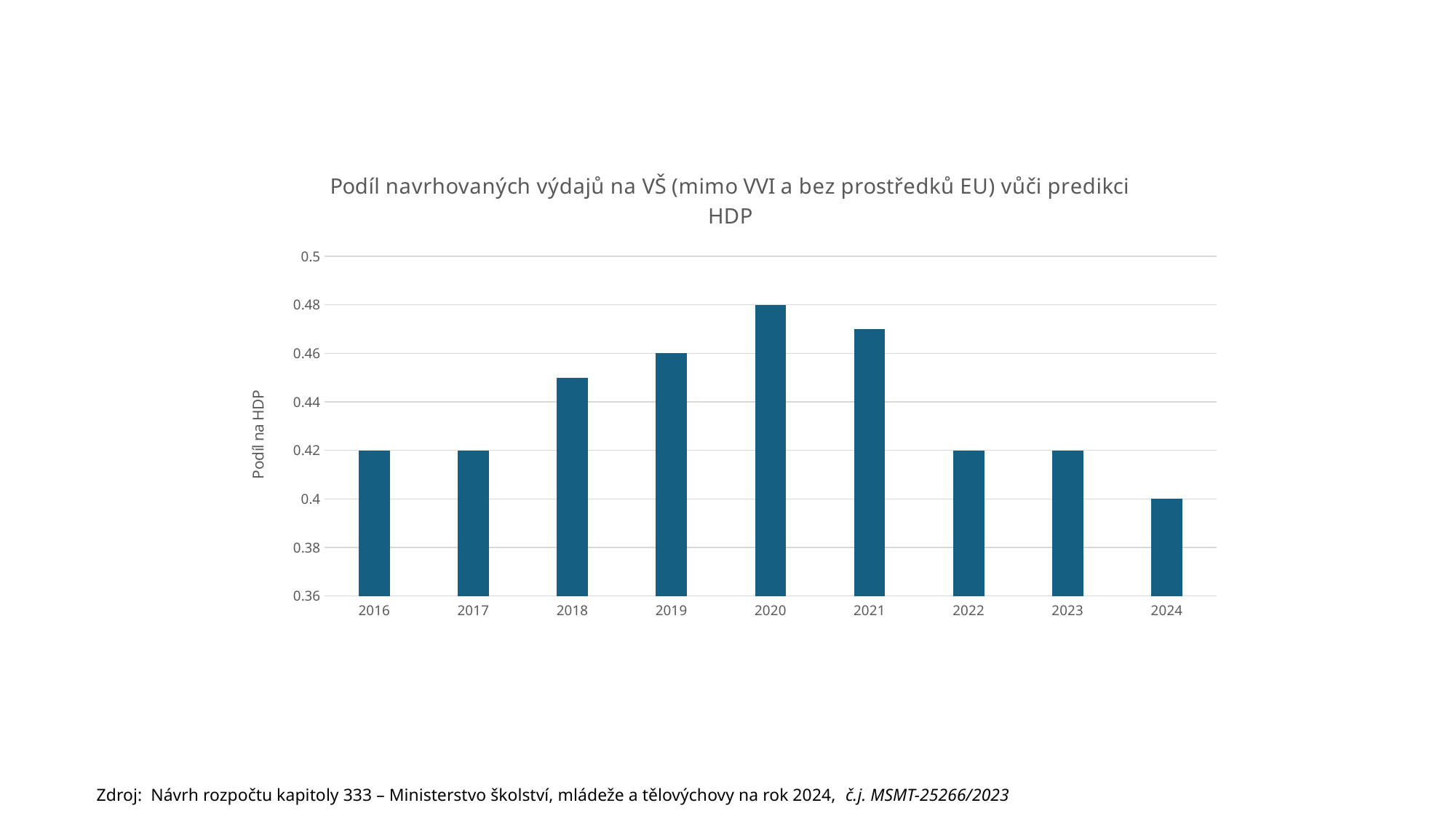
What is the value for 2016? 0.42 Which is larger, the value for 2019 or the value for 2022? 2019 What is the difference between the values for 2020 and 2024? 0.08 What is the label of the y axis? Podíl na HDP What is the value for 2020? 0.48 What kind of chart is shown on the slide? bar chart Which year has the highest value in the chart? 2020 How many years are shown on the x axis of the chart? 9 What is the value for 2024? 0.4 Is the value for 2018 greater or less than 0.44? greater Which year has the lowest value in the chart? 2024 What is the value for 2019? 0.46